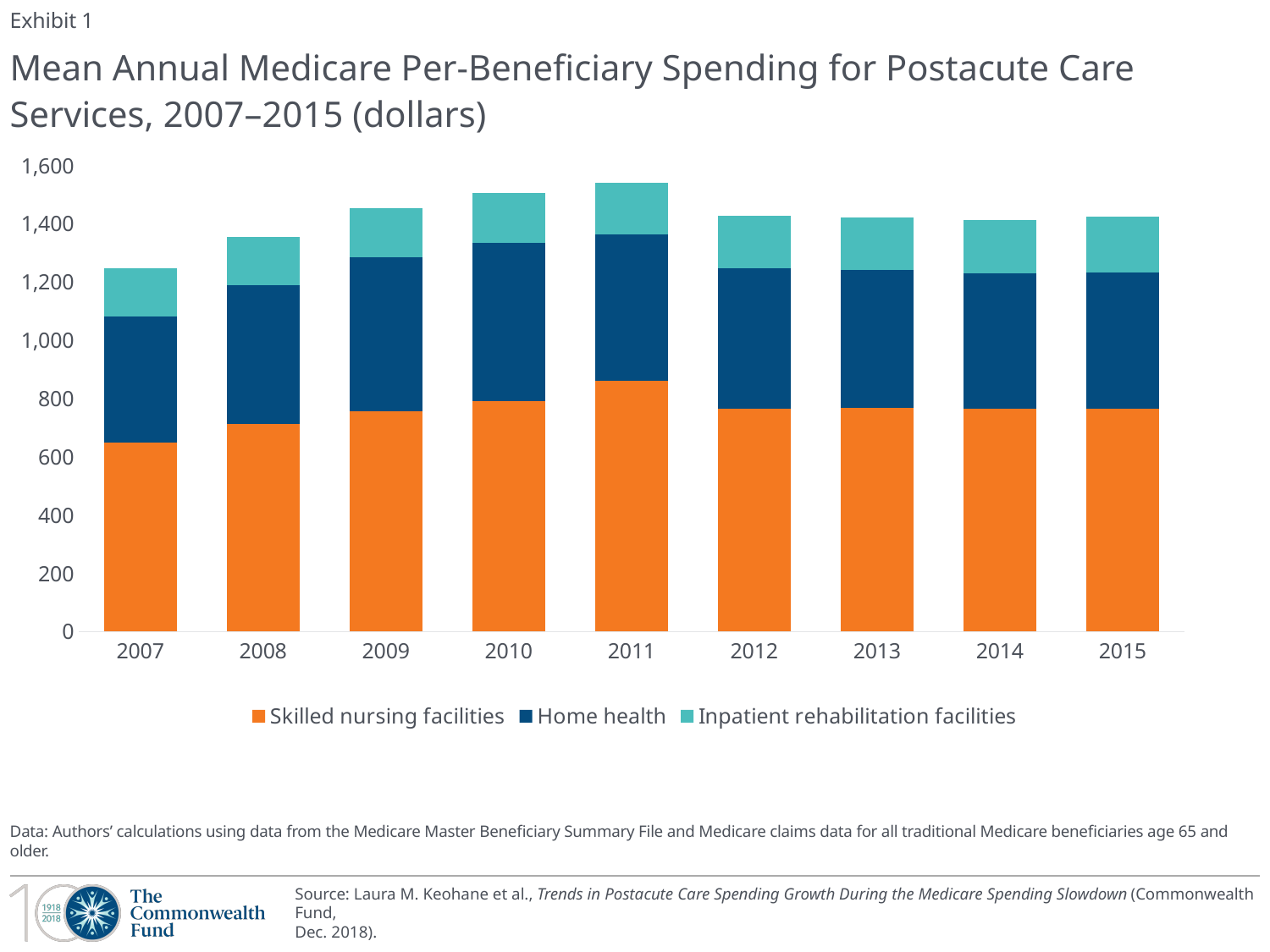
Is the total spending for 2011 greater or less than 1,400? greater Which year has the highest total mean annual per-beneficiary spending for postacute care? 2011 How many years are shown along the x axis of the chart? 9 What kind of chart is shown on the slide? Stacked bar chart Do total spending values rise or fall from 2007 to 2011? Rise Which year has the larger total spending, 2008 or 2010? 2010 Which colour represents skilled nursing facilities in the chart? Orange Which year has the lowest total mean annual per-beneficiary spending for postacute care? 2007 Is the skilled nursing facilities spending for 2007 greater or less than 800? less Is the total spending for 2007 greater or less than 1,200? greater How many series does the chart's legend list? 3